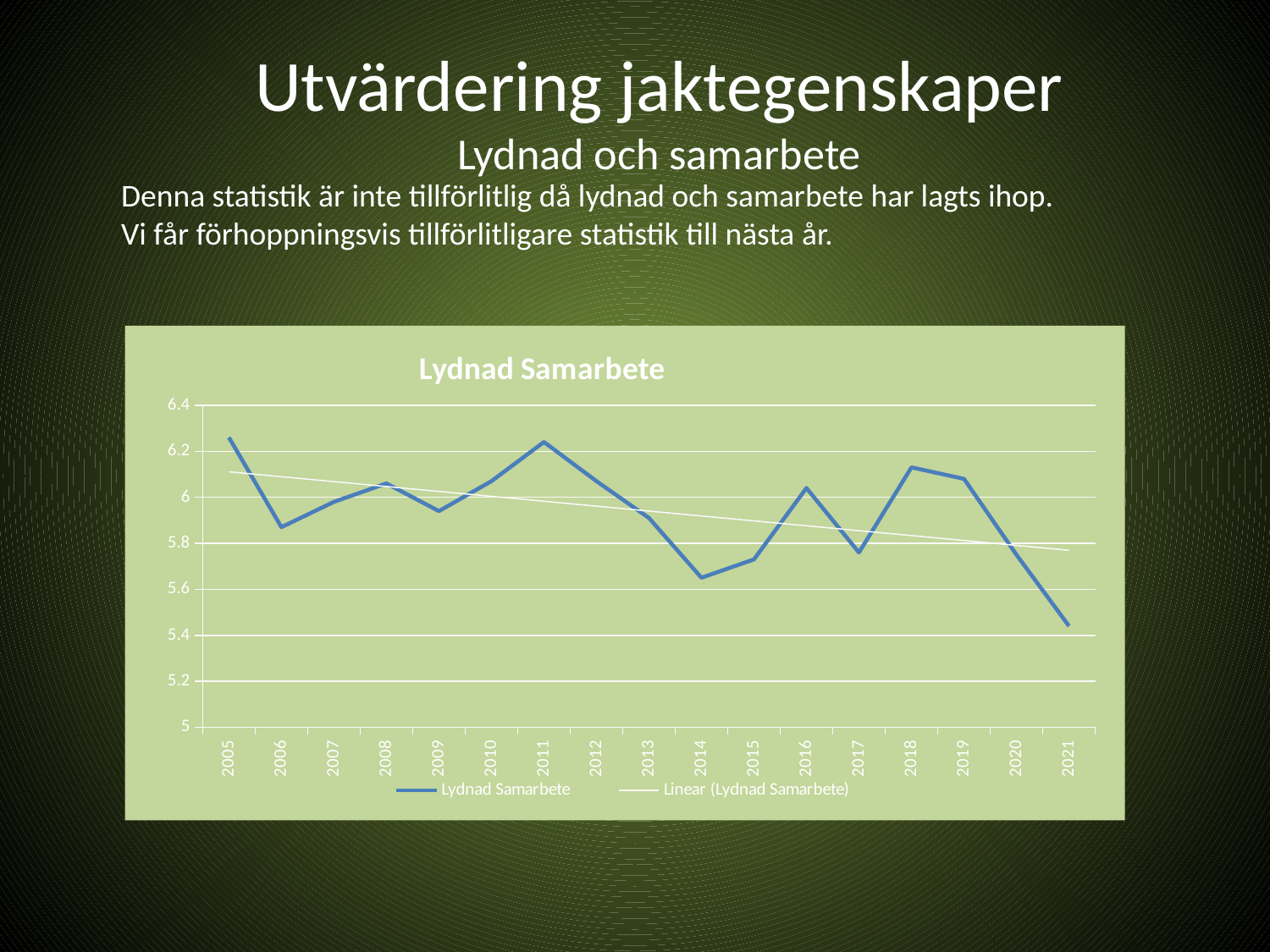
What kind of chart is shown on the slide? line chart How many years are plotted along the x axis of the chart? 17 Which year has the larger value for Lydnad Samarbete, 2014 or 2018? 2018 According to the linear trendline, do the Lydnad Samarbete values generally rise or fall from 2005 to 2021? fall Which year has the lowest value for Lydnad Samarbete? 2021 Is the value for Lydnad Samarbete in 2014 greater or less than 5.8? less Is the value for Lydnad Samarbete in 2006 greater or less than 6? less How many entries does the chart legend list? 2 Is the value for Lydnad Samarbete in 2021 greater or less than 5.6? less What is the title of the chart? Lydnad Samarbete Which year has the larger value for Lydnad Samarbete, 2005 or 2021? 2005